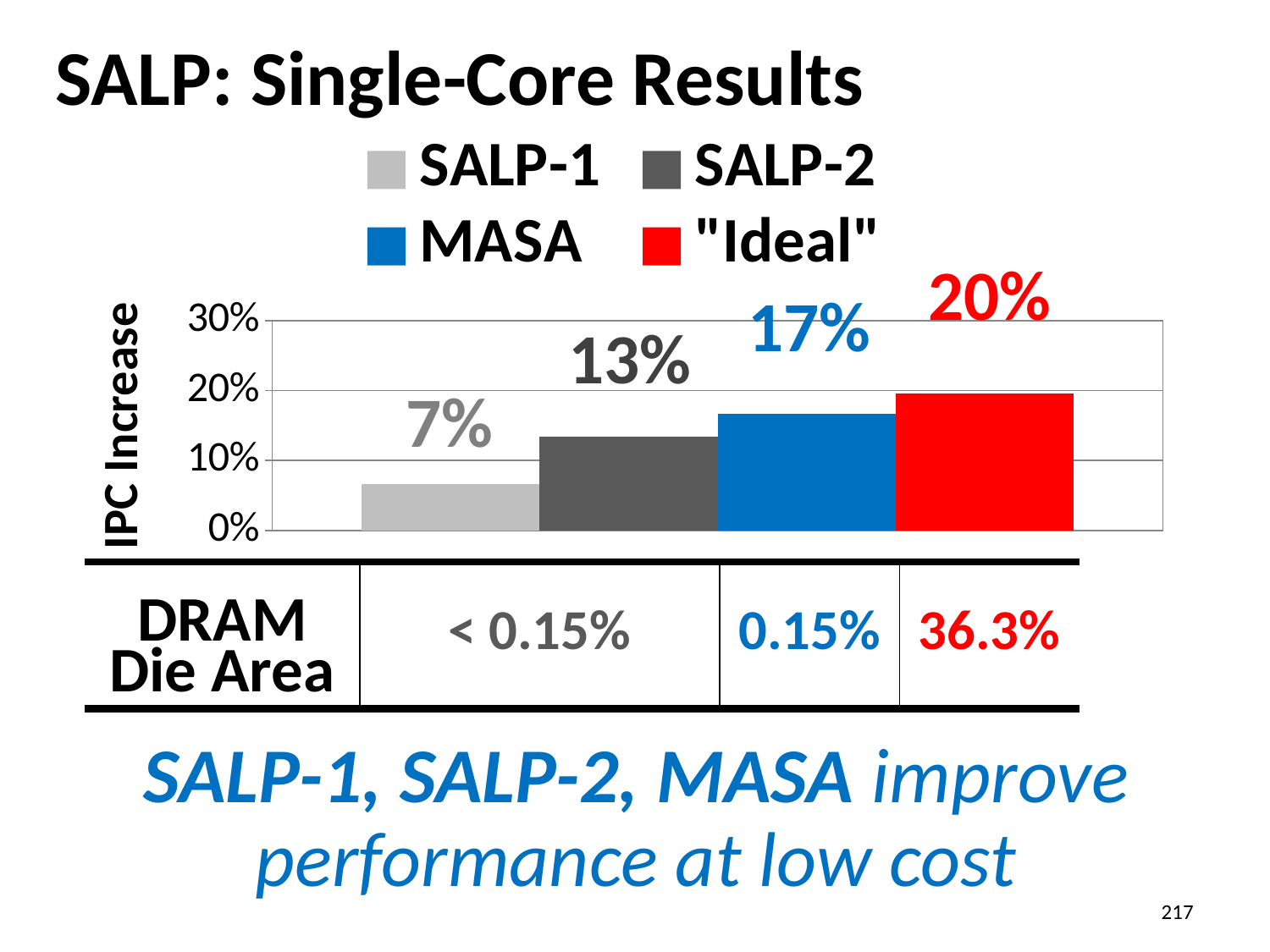
What is the IPC increase for SALP-2? 13% What is the IPC increase for "Ideal"? 20% What is the difference in IPC increase between SALP-2 and SALP-1? 6% Which series has the highest IPC increase? "Ideal" What is the label of the vertical axis? IPC Increase Which has a larger IPC increase, SALP-2 or MASA? MASA What is the IPC increase for MASA? 17% How many series does the legend list? 4 What kind of chart is shown on the slide? Bar chart What is the IPC increase for SALP-1? 7% What is the difference in IPC increase between "Ideal" and MASA? 3% Which series has the lowest IPC increase? SALP-1